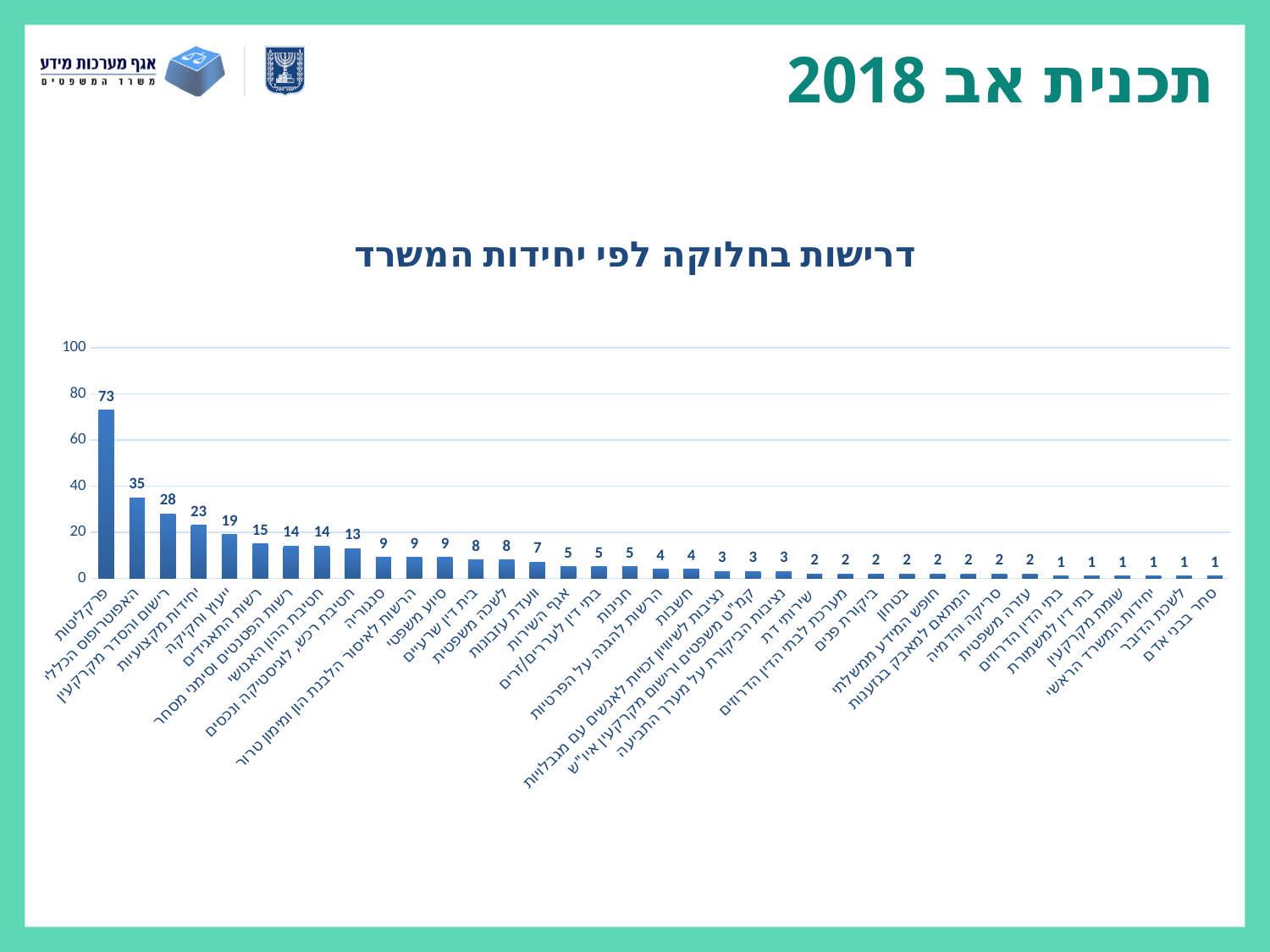
What is the difference between the values for פרקליטות and האפוטרופוס הכללי? 38 What is the value for האפוטרופוס הכללי? 35 What type of chart is shown on the slide? bar chart Do the values generally rise or fall from left to right along the x axis? fall What is the value for פרקליטות? 73 Which category has the highest value? פרקליטות What is the value for סנגוריה? 9 Which is larger, the value for רישום והסדר מקרקעין or the value for יחידות מקצועיות? רישום והסדר מקרקעין What is the value for חנינות? 5 Is the value for פרקליטות greater or less than 60? greater What is the value for ייעוץ וחקיקה? 19 What is the title of the chart? דרישות בחלוקה לפי יחידות המשרד